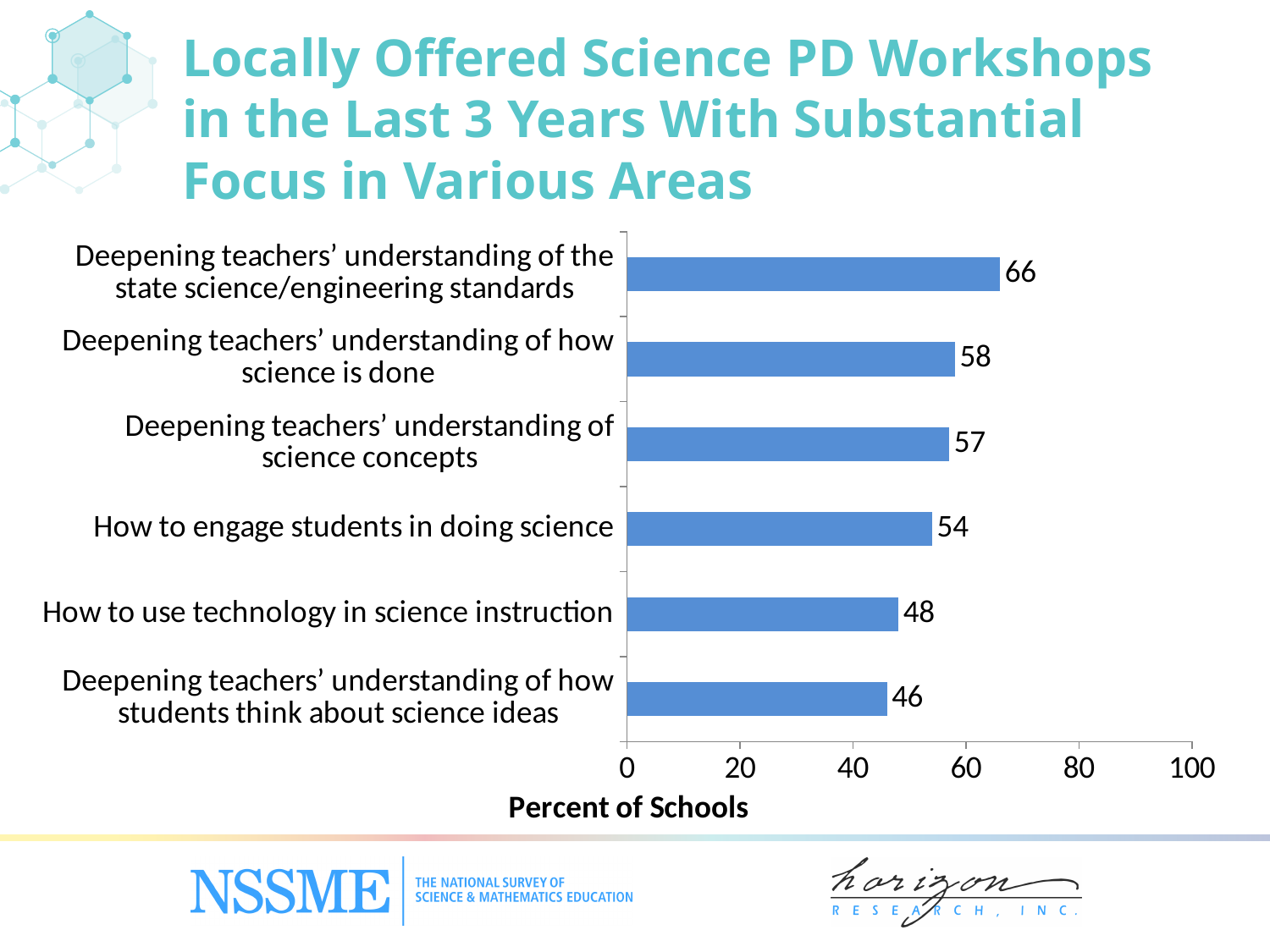
Is the value for 'Deepening teachers' understanding of science concepts' greater or less than 40? greater Which is larger: the value for 'How to engage students in doing science' or the value for 'How to use technology in science instruction'? How to engage students in doing science What is the label of the horizontal axis? Percent of Schools What is the value for 'How to engage students in doing science'? 54 What is the value for 'How to use technology in science instruction'? 48 What is the difference between the values for 'Deepening teachers' understanding of how science is done' and 'How to use technology in science instruction'? 10 What percent of schools offered PD workshops with substantial focus on deepening teachers' understanding of the state science/engineering standards? 66 How many areas are shown in the chart? 6 Which area has the lowest percent of schools? Deepening teachers' understanding of how students think about science ideas What is the difference between the values for 'Deepening teachers' understanding of the state science/engineering standards' and 'Deepening teachers' understanding of how students think about science ideas'? 20 What kind of chart is shown on the slide? Bar chart Which area has the highest percent of schools? Deepening teachers' understanding of the state science/engineering standards